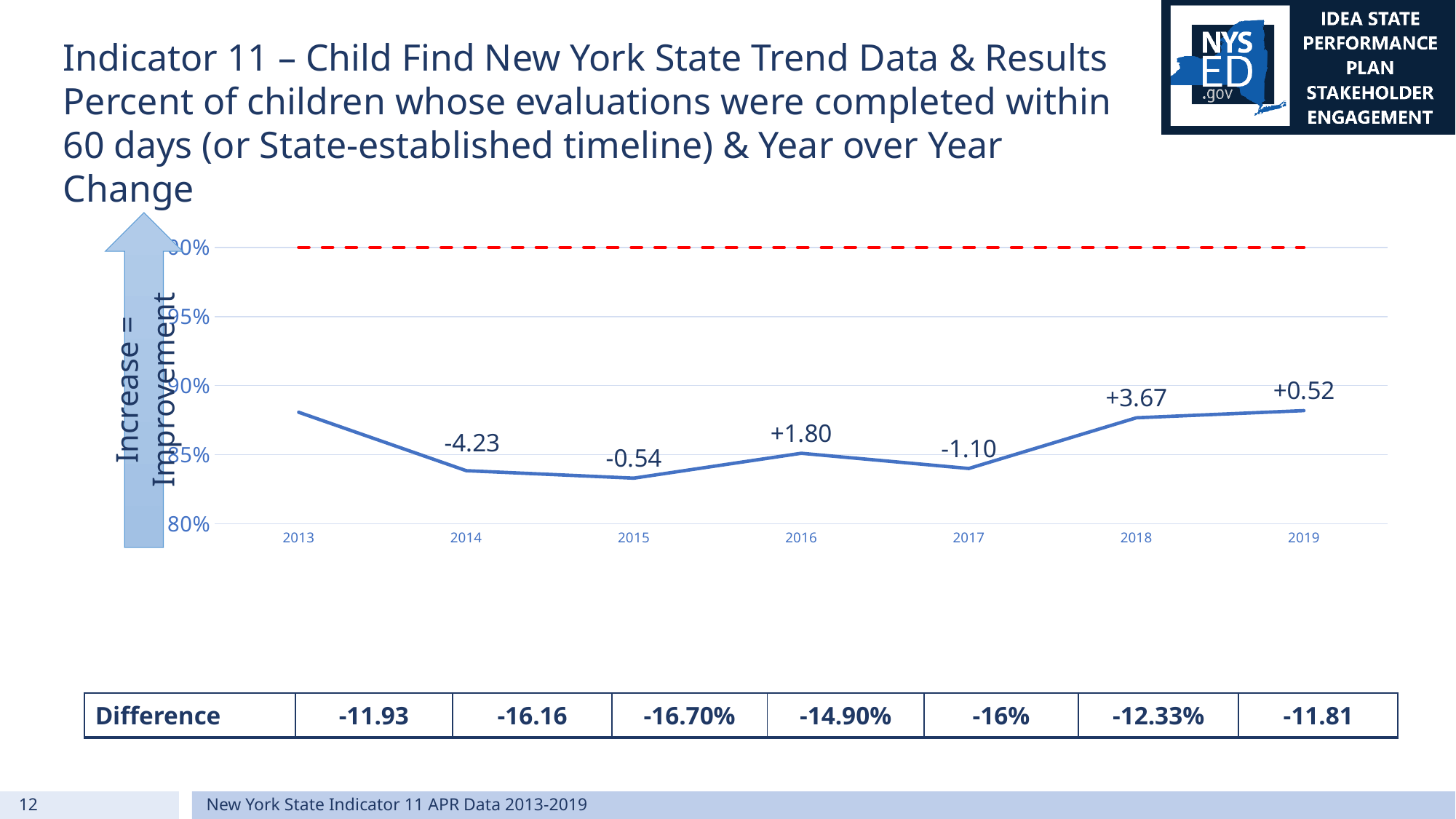
Is the plotted value for 2015 greater or less than 85%? less What year-over-year change is labelled on the chart for 2016? +1.80 What kind of chart is shown on the slide? line chart What year-over-year change is labelled on the chart for 2018? +3.67 Is the plotted value for 2013 greater or less than 85%? greater What year-over-year change is labelled on the chart for 2014? -4.23 Which year has the largest positive year-over-year change label on the chart? 2018 Which year has the most negative year-over-year change label on the chart? 2014 Does the plotted line rise or fall from 2017 to 2019? rise How many years are plotted along the x axis of the chart? 7 In the Difference row of the table below the chart, what value is shown in the 2016 column? -14.90% Which year has the higher plotted value, 2014 or 2018? 2018